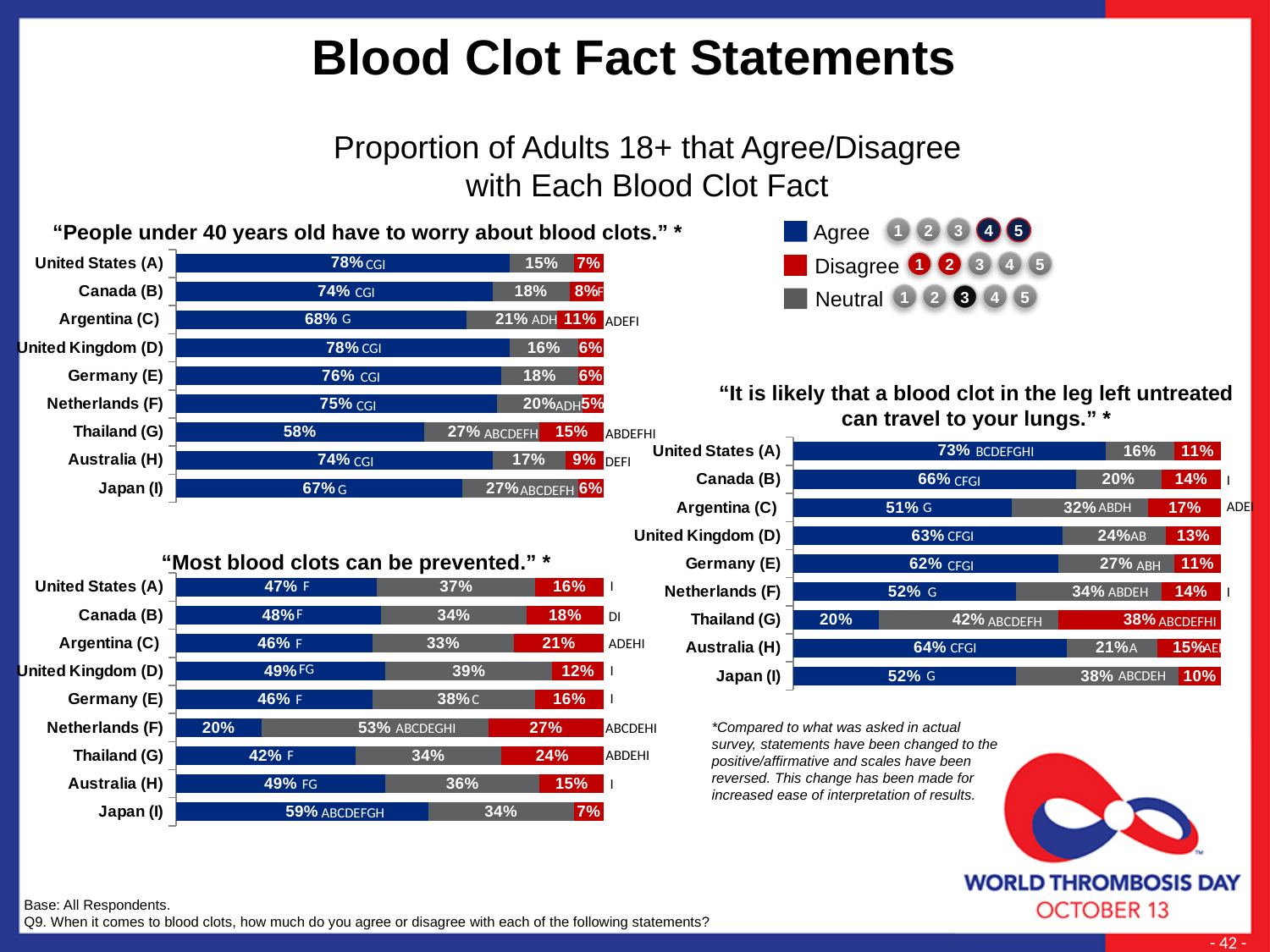
What type of chart is used for "People under 40 years old have to worry about blood clots"? Stacked bar chart In the chart "People under 40 years old have to worry about blood clots," what is the difference between the Agree percentages for the United States (A) and Argentina (C)? 10% In the chart "People under 40 years old have to worry about blood clots," what percentage of adults in Thailand (G) agree? 58% In the chart "It is likely that a blood clot in the leg left untreated can travel to your lungs," which country has the highest Agree percentage? United States (A) How many countries are shown in the chart "Most blood clots can be prevented"? 9 In the chart "People under 40 years old have to worry about blood clots," which country has the lowest Agree percentage? Thailand (G) In the chart "Most blood clots can be prevented," which country has the highest Agree percentage? Japan (I) In the chart "Most blood clots can be prevented," which is larger: the Disagree percentage for Argentina (C) or for the United Kingdom (D)? Argentina (C) In the chart "Most blood clots can be prevented," what percentage of adults in the Netherlands (F) are Neutral? 53% How many response categories does the legend list for the charts on this slide? 3 In the chart "It is likely that a blood clot in the leg left untreated can travel to your lungs," what is the difference between the Agree percentages for Canada (B) and Argentina (C)? 15% In the chart "It is likely that a blood clot in the leg left untreated can travel to your lungs," what percentage of adults in Thailand (G) disagree? 38%